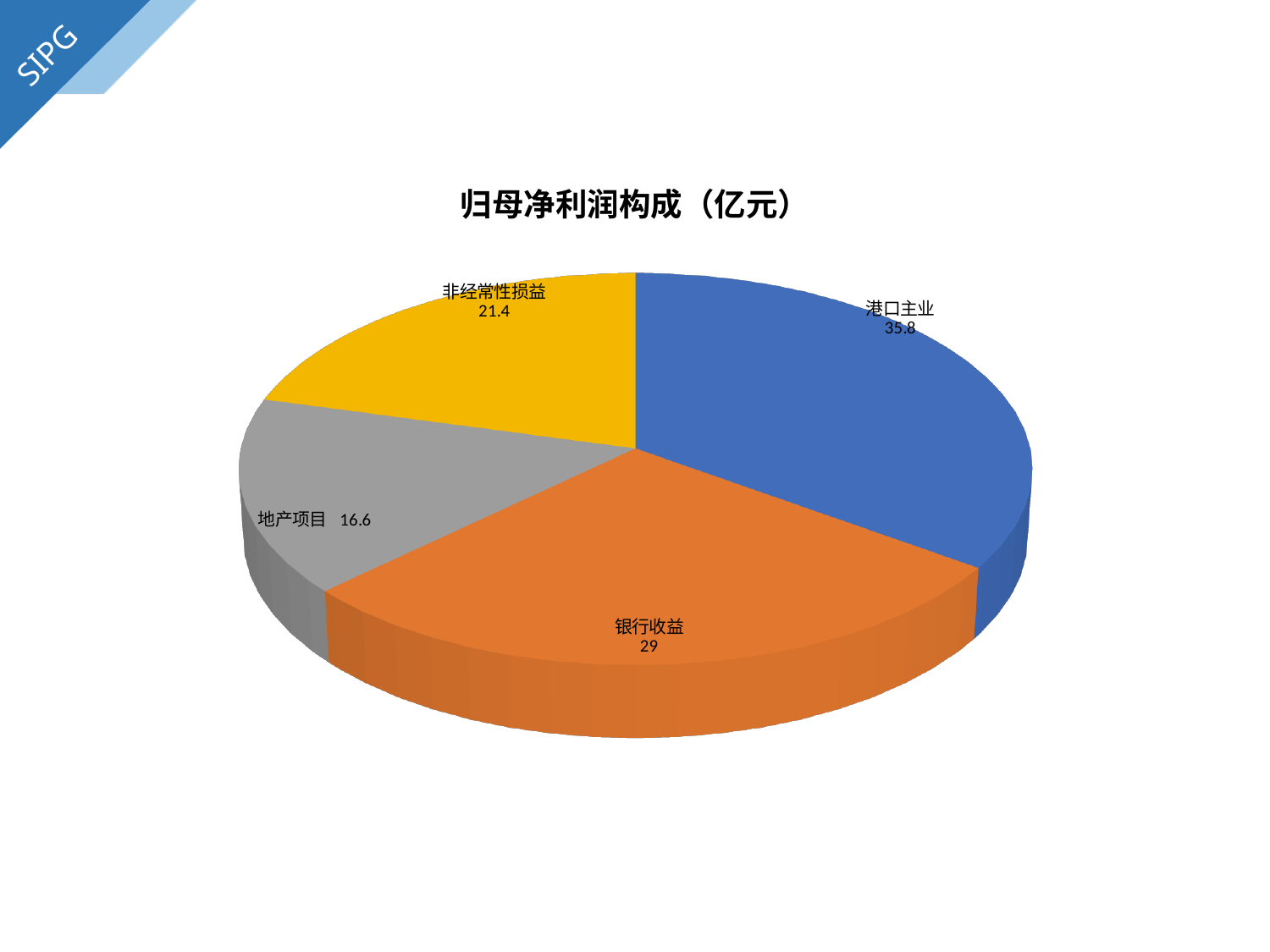
What is the value for 非经常性损益? 21.4 What is the title of the chart? 归母净利润构成（亿元） What is the value for 银行收益? 29 What is the value for 港口主业? 35.8 What is the value for 地产项目? 16.6 What colour is the 银行收益 slice? orange What type of chart is shown on the slide? pie chart What is the difference between the values for 港口主业 and 银行收益? 6.8 Which category has the smallest value? 地产项目 How many slices does the pie chart have? 4 Which category has the largest value? 港口主业 Which is larger, the value for 非经常性损益 or the value for 地产项目? 非经常性损益